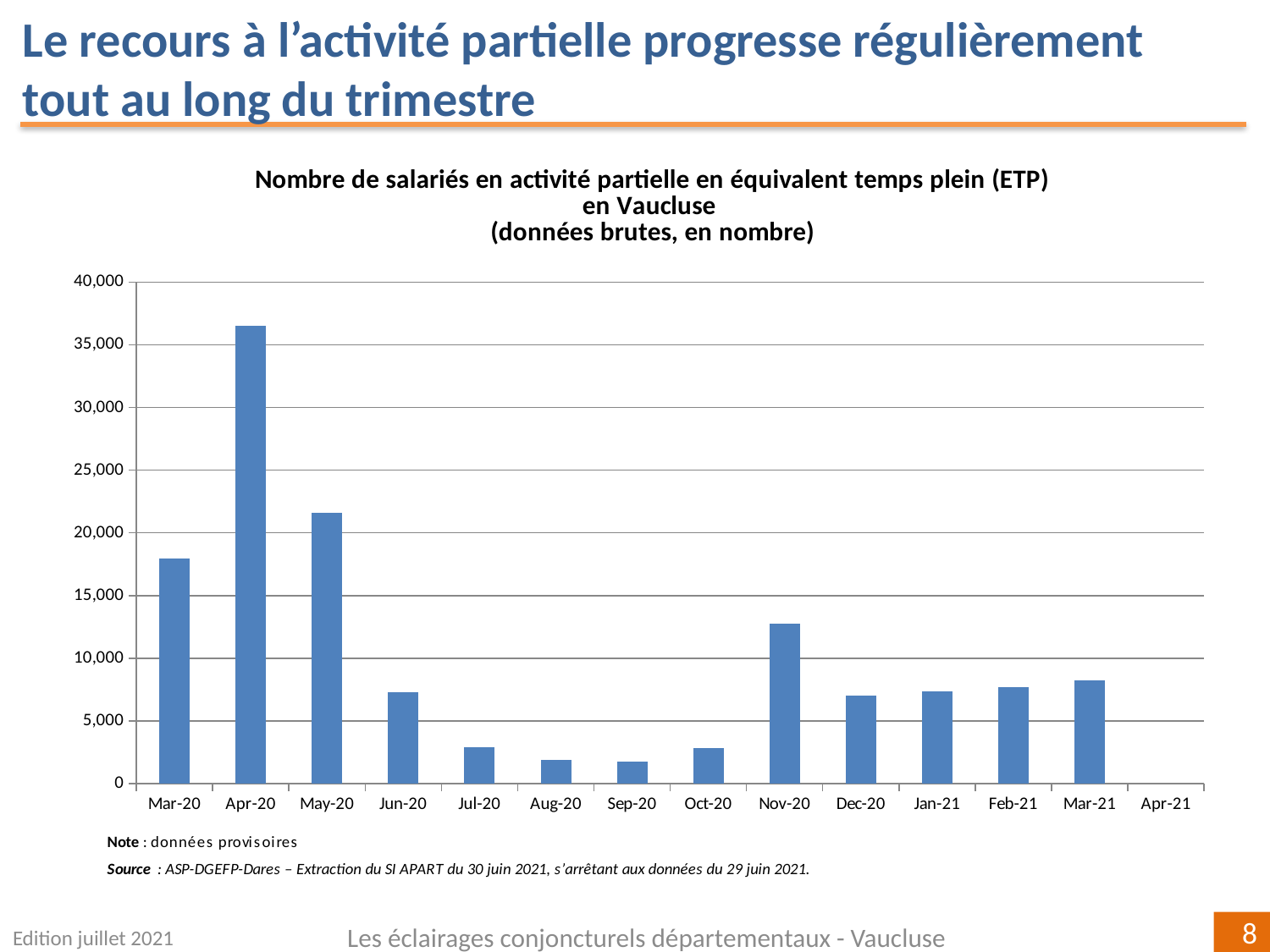
How many months are labelled on the x axis of the chart? 14 Which is larger, the value for Mar-20 or the value for May-20? Mar-20 Is the value for Mar-20 greater or less than 15,000? greater Which month has the highest number of salariés en activité partielle (ETP)? Apr-20 Is the value for Mar-21 greater or less than 10,000? less Is the value for Nov-20 greater or less than 10,000? greater What kind of chart is shown on the slide? bar chart Which is larger, the value for Nov-20 or the value for Dec-20? Nov-20 Do the values rise or fall from Dec-20 to Mar-21? rise According to the note under the chart, what is the nature of the data? données provisoires